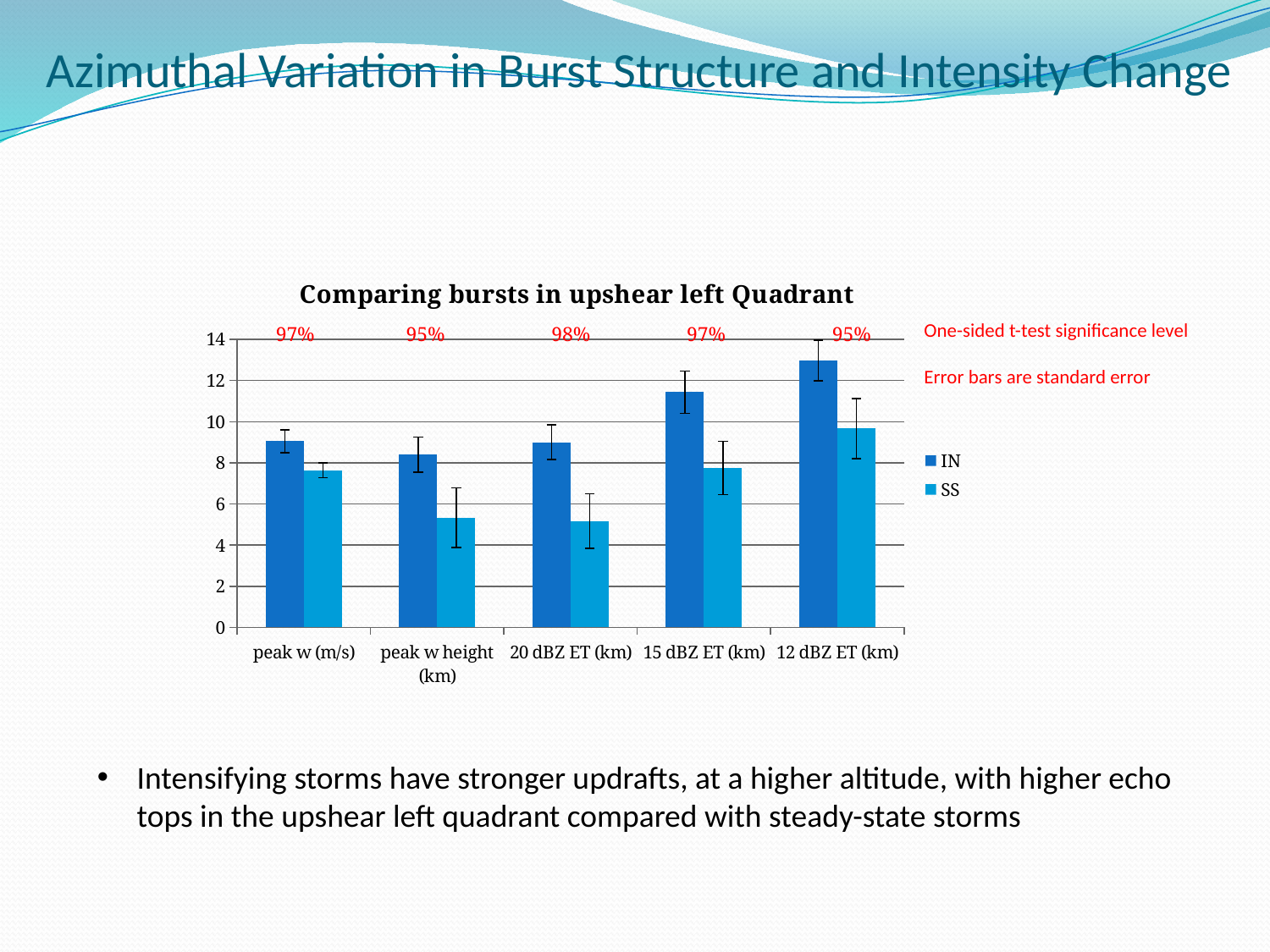
What is the title of the chart? Comparing bursts in upshear left Quadrant For peak w height (km), which series has the larger value, IN or SS? IN Is the IN value for 15 dBZ ET (km) greater or less than 10? greater How many categories are shown on the x axis? 5 How many series does the legend list? 2 For 15 dBZ ET (km), which series has the larger value, IN or SS? IN What one-sided t-test significance level is printed above the 20 dBZ ET (km) category? 98% Is the IN value for 12 dBZ ET (km) greater or less than 12? greater Which category has the highest IN value? 12 dBZ ET (km) Is the SS value for 20 dBZ ET (km) greater or less than 6? less Which category has the highest SS value? 12 dBZ ET (km) What kind of chart is shown on the slide? bar chart